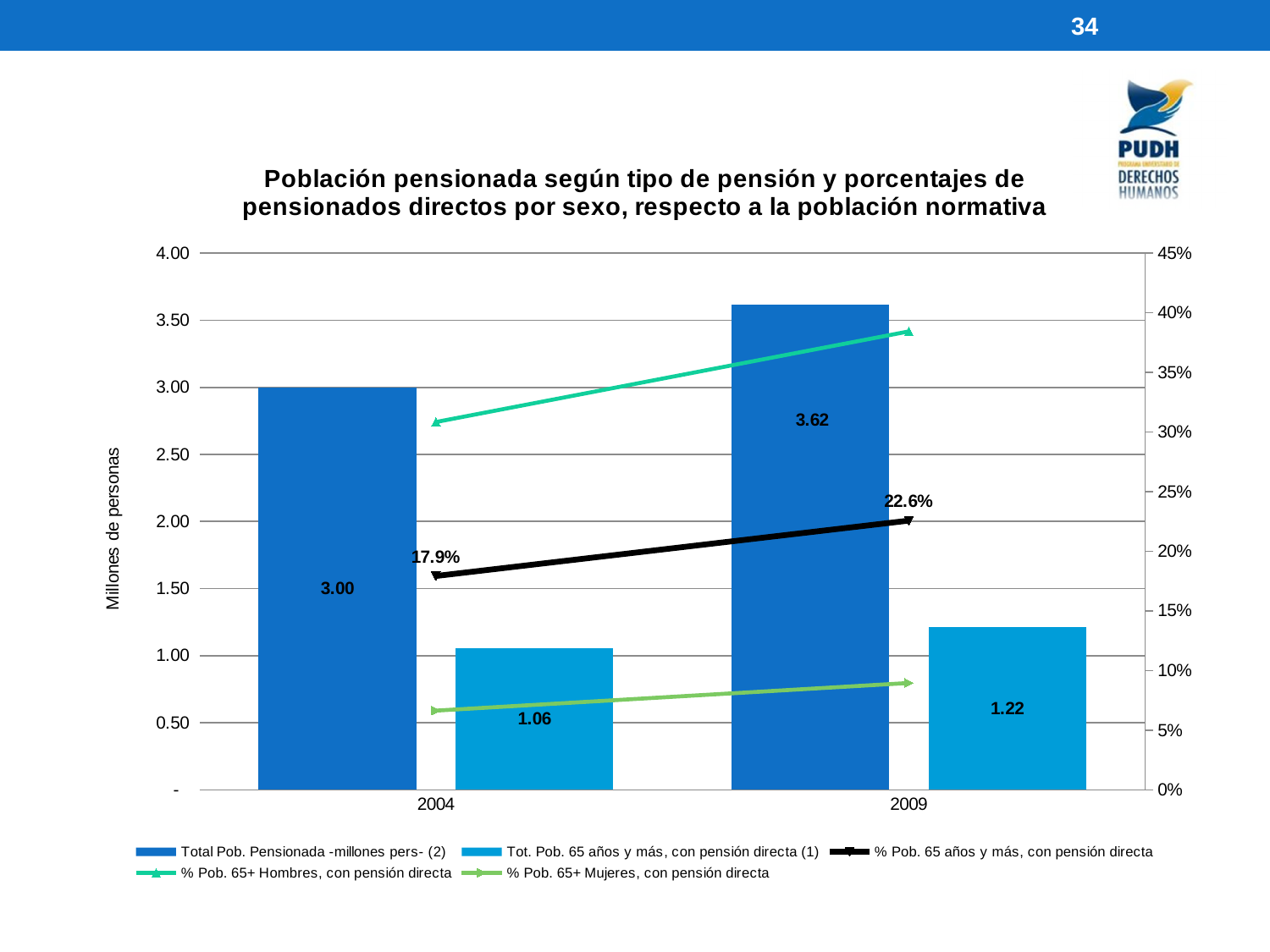
Does the % Pob. 65 años y más, con pensión directa rise or fall from 2004 to 2009? rise What is the % Pob. 65 años y más, con pensión directa for 2004? 17.9% What is the label of the left vertical axis? Millones de personas What is the difference between Tot. Pob. 65 años y más, con pensión directa (1) in 2009 and in 2004? 0.16 What is the value of Total Pob. Pensionada -millones pers- (2) for 2009? 3.62 How many series does the legend list? 5 Is the % Pob. 65+ Mujeres, con pensión directa for 2004 greater or less than 10%? less By how much did Total Pob. Pensionada -millones pers- (2) increase from 2004 to 2009? 0.62 What is the value of Total Pob. Pensionada -millones pers- (2) for 2004? 3.00 What is the % Pob. 65 años y más, con pensión directa for 2009? 22.6% Is the % Pob. 65+ Hombres, con pensión directa for 2009 greater or less than 35%? greater What is the value of Tot. Pob. 65 años y más, con pensión directa (1) for 2009? 1.22